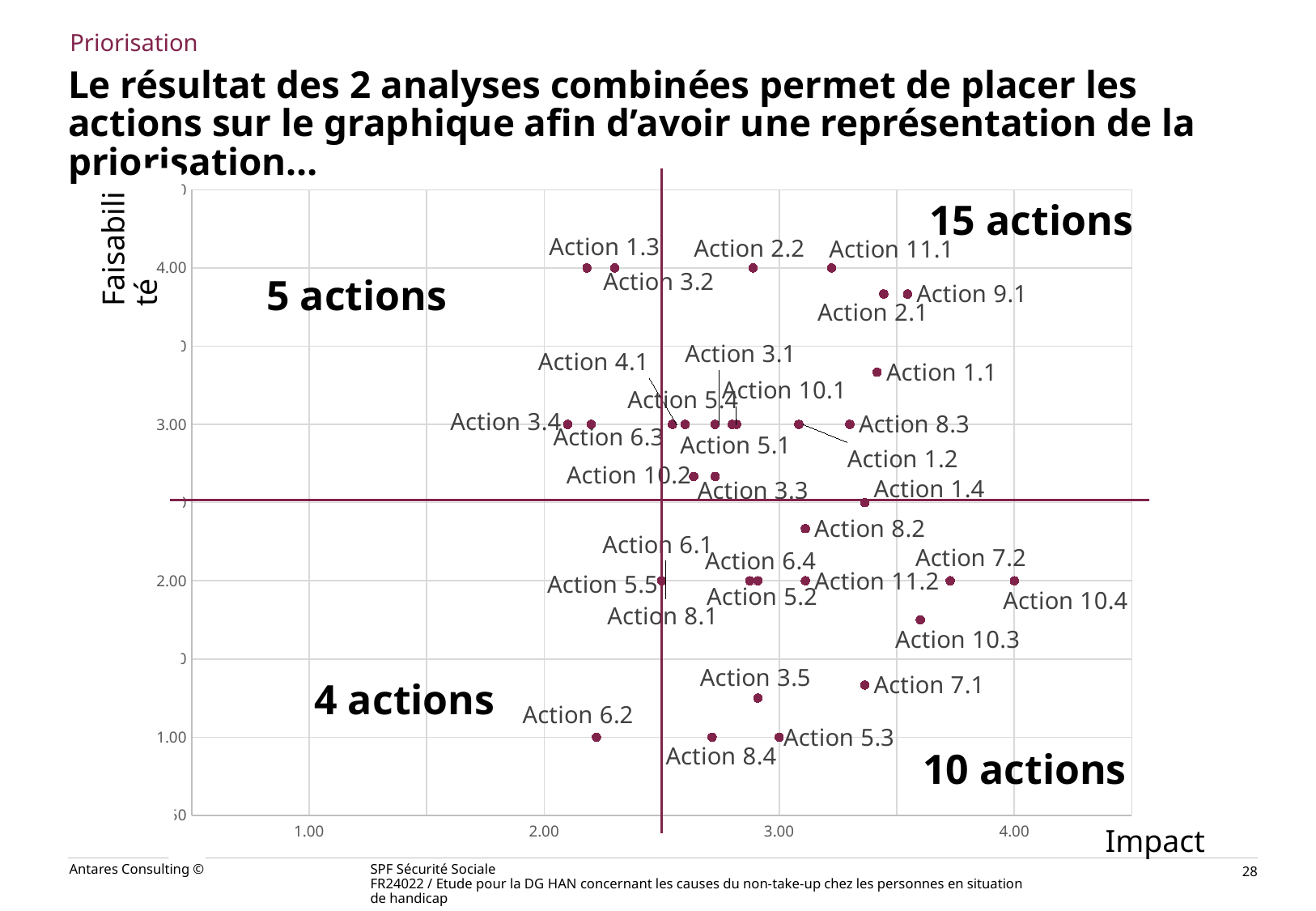
Is the Faisabilité value for Action 10.3 greater or less than 2.00? less What kind of chart is shown on the slide? scatter chart How many actions does the chart indicate in the bottom-left quadrant? 4 actions Which action has the highest Impact value? Action 10.4 What is the label of the vertical axis of the chart? Faisabilité How many actions does the chart indicate in the top-right quadrant? 15 actions Which has the higher Faisabilité value, Action 9.1 or Action 7.1? Action 9.1 What is the Faisabilité value of Action 6.2? 1.00 Is the Faisabilité value for Action 9.1 greater or less than 3.00? greater What is the Faisabilité value of Action 11.1? 4.00 What is the Impact value of Action 10.4? 4.00 What is the label of the horizontal axis of the chart? Impact